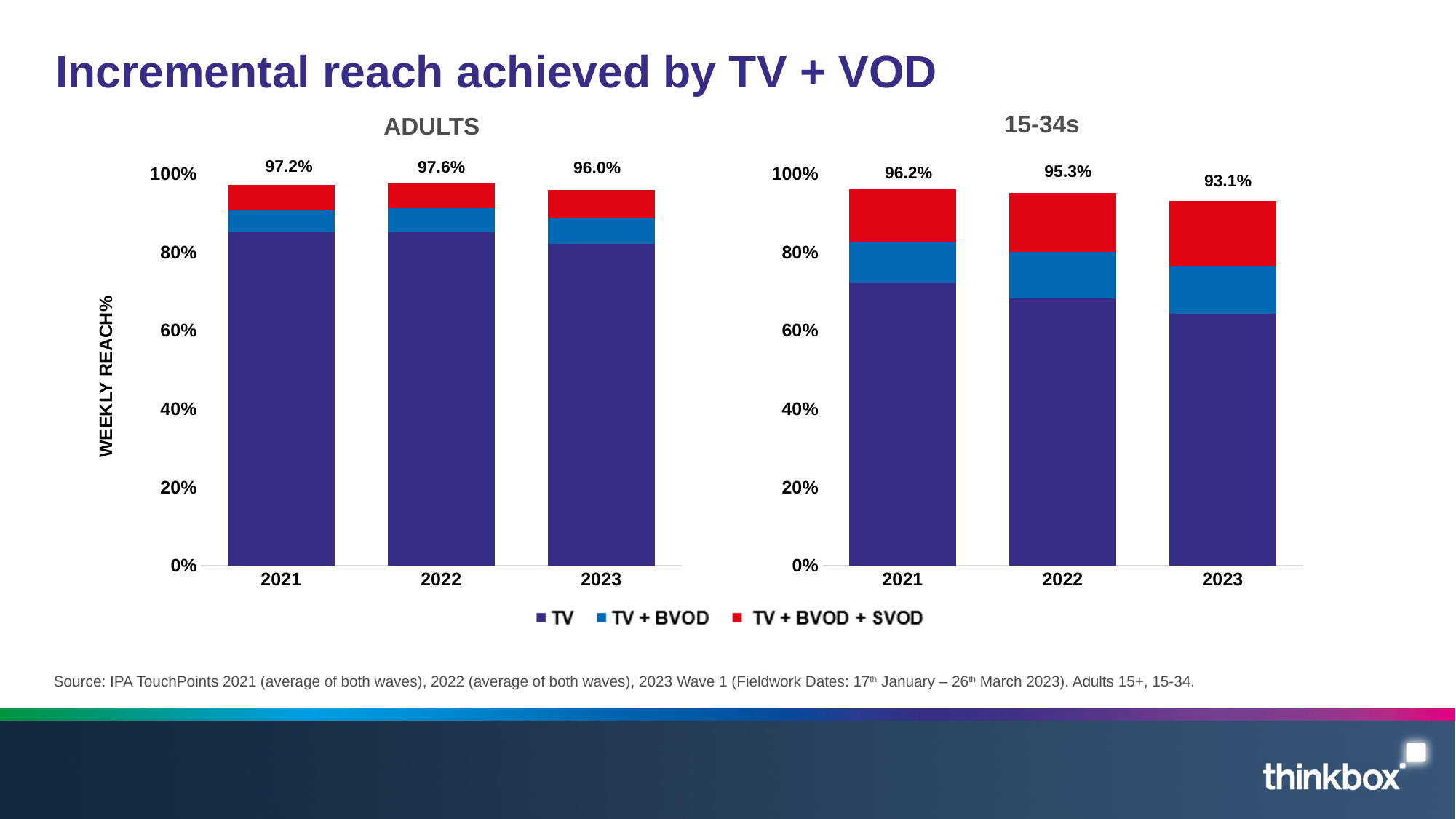
In the 15-34s chart, which year has the lowest total weekly reach? 2023 In the 15-34s chart, is the TV segment for 2023 greater or less than 80%? less In the ADULTS chart, is the TV segment for 2021 greater or less than 80%? greater In the 15-34s chart, what is the difference between the total weekly reach in 2021 and in 2023? 3.1% How many years are shown on the x axis of the 15-34s chart? 3 In the ADULTS chart, which year has the highest total weekly reach? 2022 How many series does the legend list? 3 In the ADULTS chart, what is the total weekly reach shown for 2022? 97.6% In the 15-34s chart, what is the total weekly reach shown for 2023? 93.1% In the 15-34s chart, does the total weekly reach rise or fall from 2021 to 2023? Fall What kind of chart is the ADULTS chart? Stacked bar chart Which is larger: the 2023 total weekly reach in the ADULTS chart or in the 15-34s chart? ADULTS